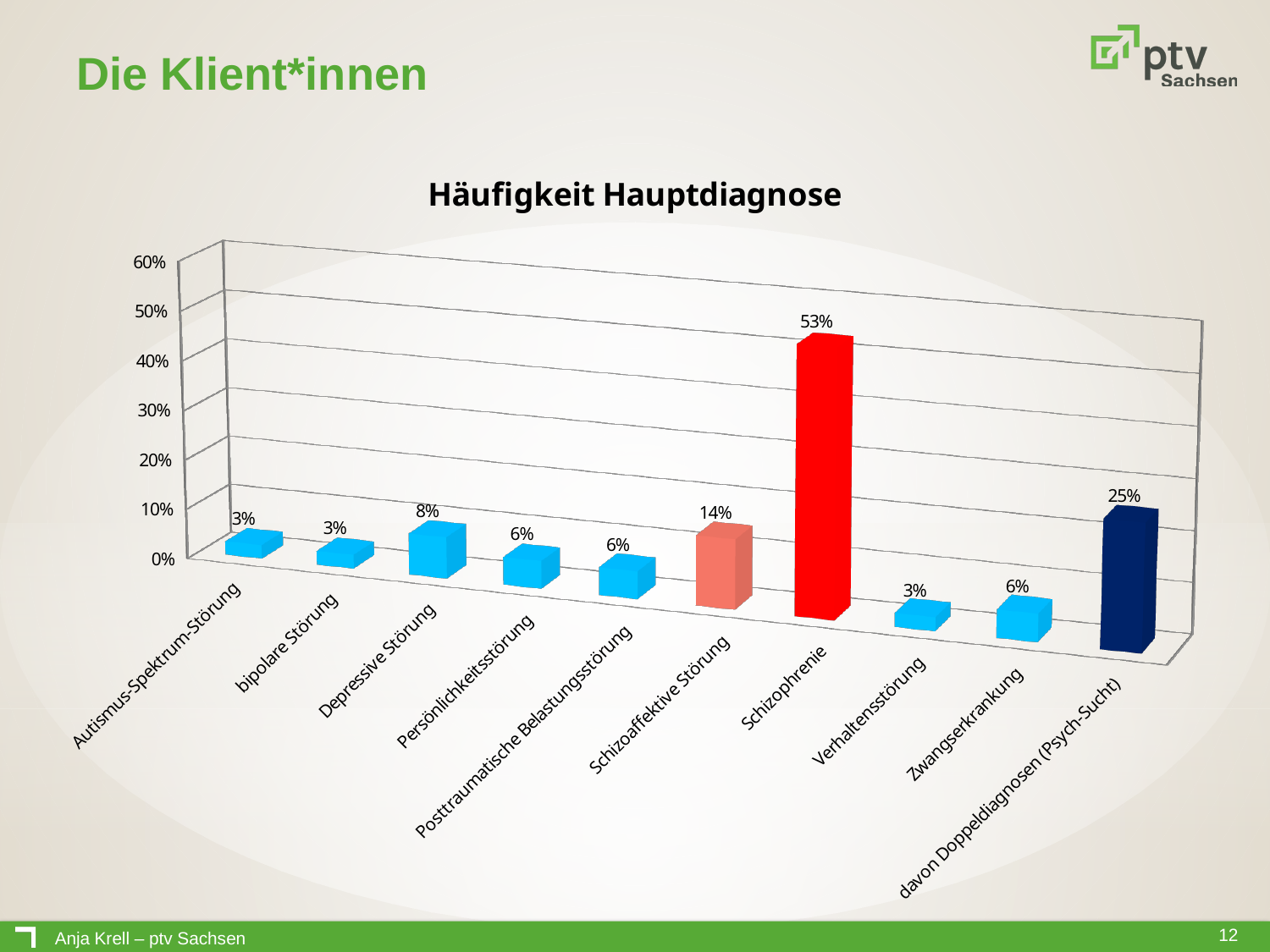
What is the difference between the values for Schizophrenie and davon Doppeldiagnosen (Psych-Sucht)? 28% What is the value for Zwangserkrankung? 6% What is the value for Schizophrenie in the Häufigkeit Hauptdiagnose chart? 53% What is the value for davon Doppeldiagnosen (Psych-Sucht)? 25% Which is larger, the value for Depressive Störung or the value for Persönlichkeitsstörung? Depressive Störung What is the value for Schizoaffektive Störung? 14% What is the value for Depressive Störung? 8% What is the difference between the values for Schizoaffektive Störung and Depressive Störung? 6% How many categories are shown in the chart? 10 Is the value for Schizophrenie greater or less than 50%? greater Which category has the highest value in the chart? Schizophrenie What kind of chart is shown on the slide? bar chart